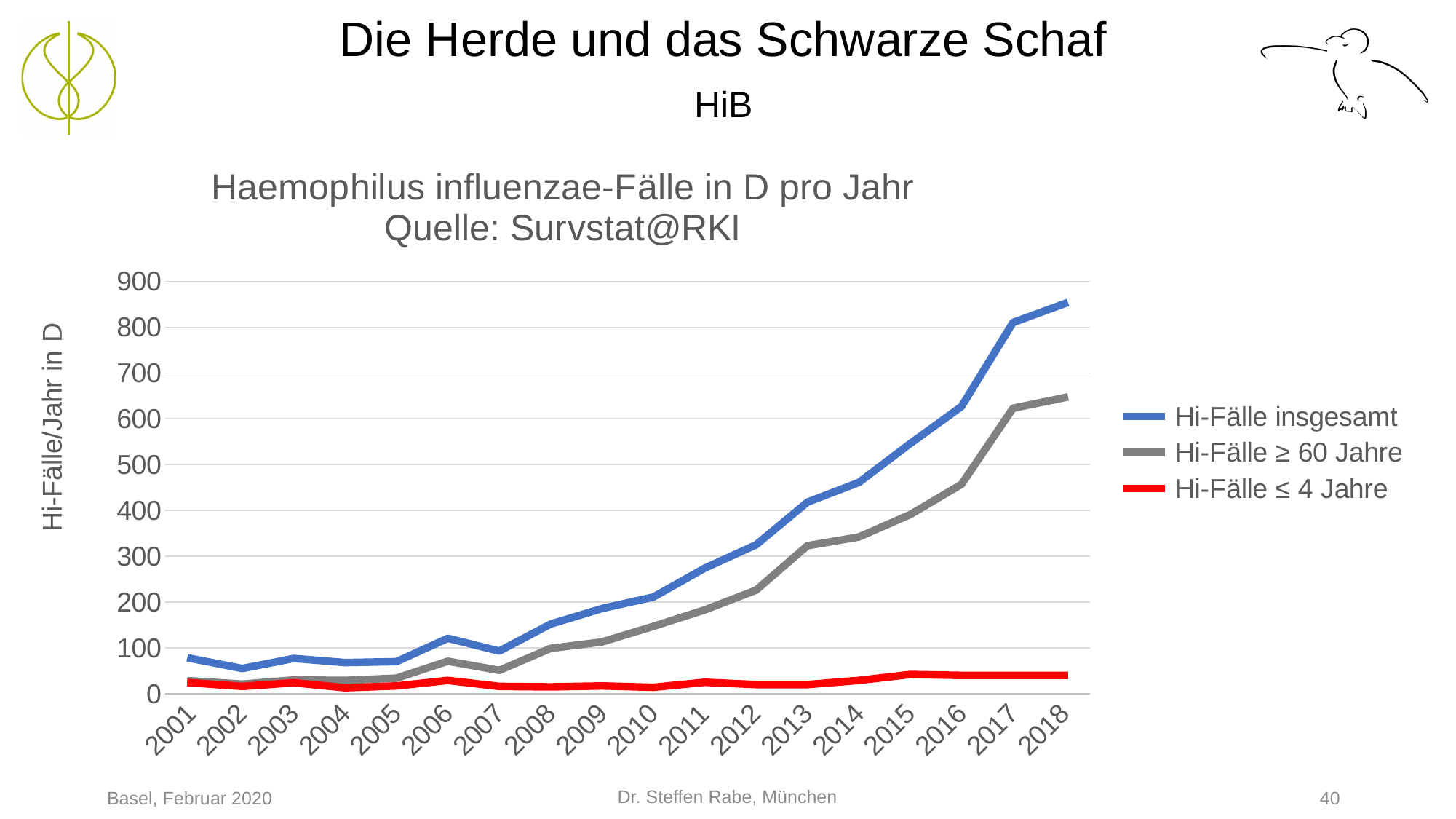
Is the value for Hi-Fälle ≥ 60 Jahre in 2017 greater or less than 600? greater Is the value for Hi-Fälle ≤ 4 Jahre in 2018 greater or less than 100? less Do the values for Hi-Fälle insgesamt rise or fall from 2001 to 2018? rise How many series does the legend list? 3 In 2018, which is larger: Hi-Fälle insgesamt or Hi-Fälle ≥ 60 Jahre? Hi-Fälle insgesamt Is the value for Hi-Fälle insgesamt in 2010 greater or less than 300? less Which series has the lowest value in 2018? Hi-Fälle ≤ 4 Jahre How many years are plotted along the x axis? 18 In which year is the value for Hi-Fälle insgesamt highest? 2018 What is the label of the y axis? Hi-Fälle/Jahr in D What kind of chart is shown on the slide? line chart